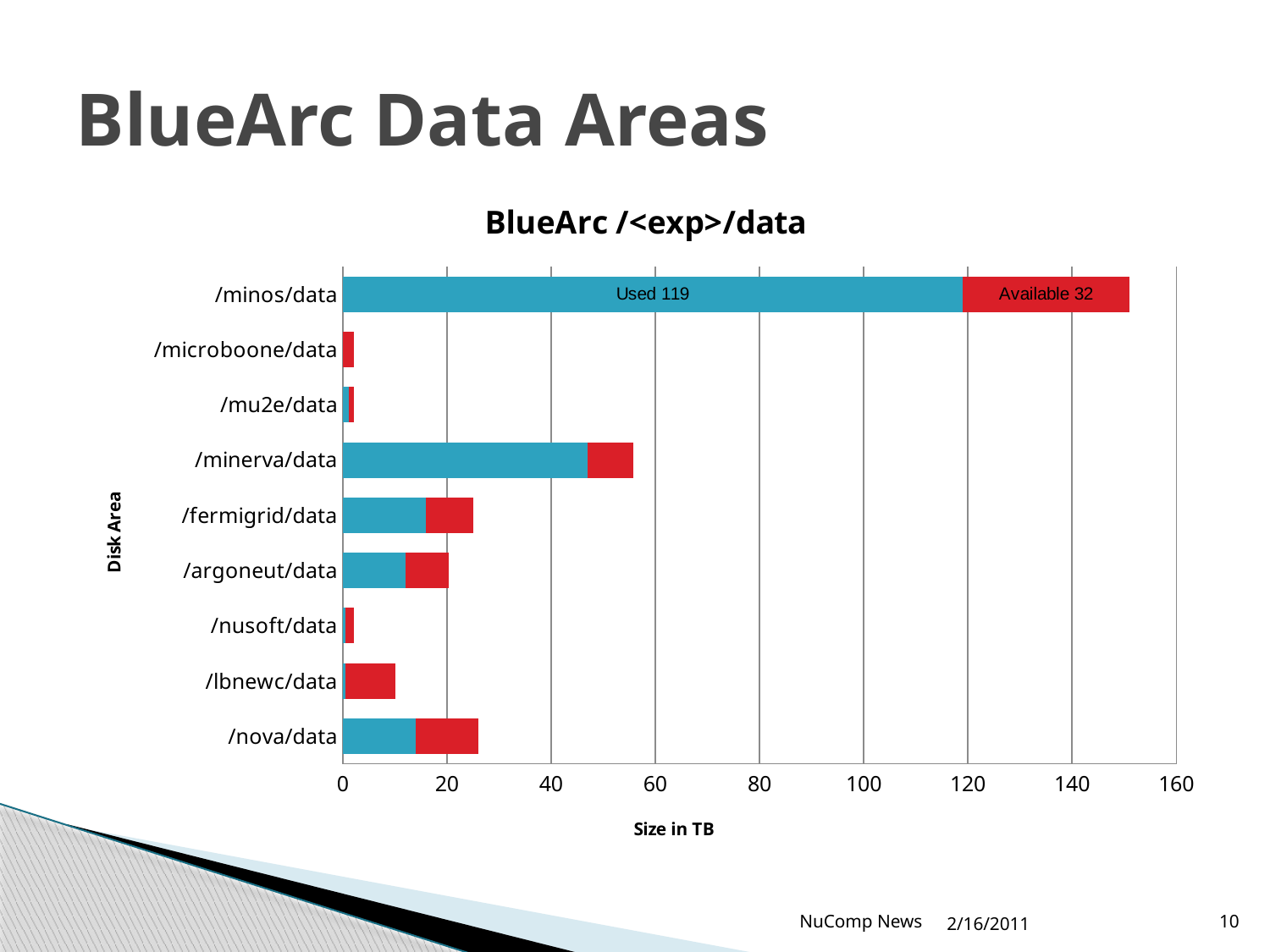
What is the total size (Used plus Available) of the /minos/data bar? 151 What is the title of the chart? BlueArc /<exp>/data What is the label on the horizontal axis of the chart? Size in TB Which has a larger total bar, /minerva/data or /fermigrid/data? /minerva/data What is the Used value for /minos/data? 119 Which has a larger total bar, /lbnewc/data or /nova/data? /nova/data How many disk areas are listed on the chart? 9 What is the Available value for /minos/data? 32 Is the total value for /argoneut/data greater or less than 40? less What kind of chart is shown on the slide? bar chart Which disk area has the largest total bar? /minos/data Is the total value for /minerva/data greater or less than 40? greater